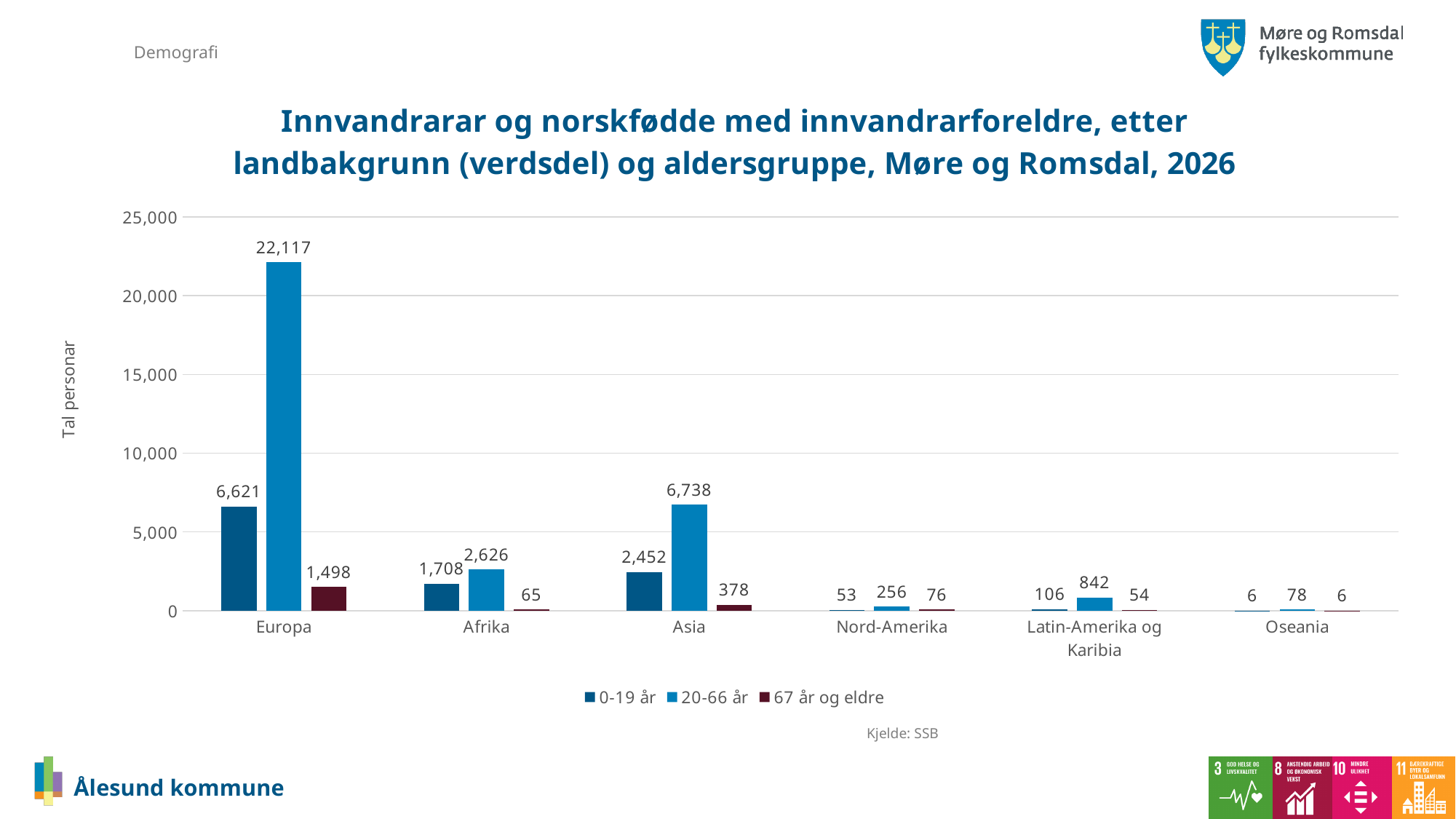
What kind of chart is shown on the slide? Bar chart What is the value for Afrika in the 67 år og eldre series? 65 How many categories (world regions) are shown on the x axis? 6 Which category has the highest value in the 20-66 år series? Europa What is the total of the three age-group values for Nord-Amerika? 385 Which is larger: the 0-19 år value for Afrika or the 0-19 år value for Asia? Asia What is the difference between the 20-66 år values for Europa and Asia? 15,379 Which category has the lowest value in the 0-19 år series? Oseania What is the value for Asia in the 0-19 år series? 2,452 What is the value for Europa in the 20-66 år series? 22,117 How many series does the legend list? 3 What is the value for Latin-Amerika og Karibia in the 20-66 år series? 842